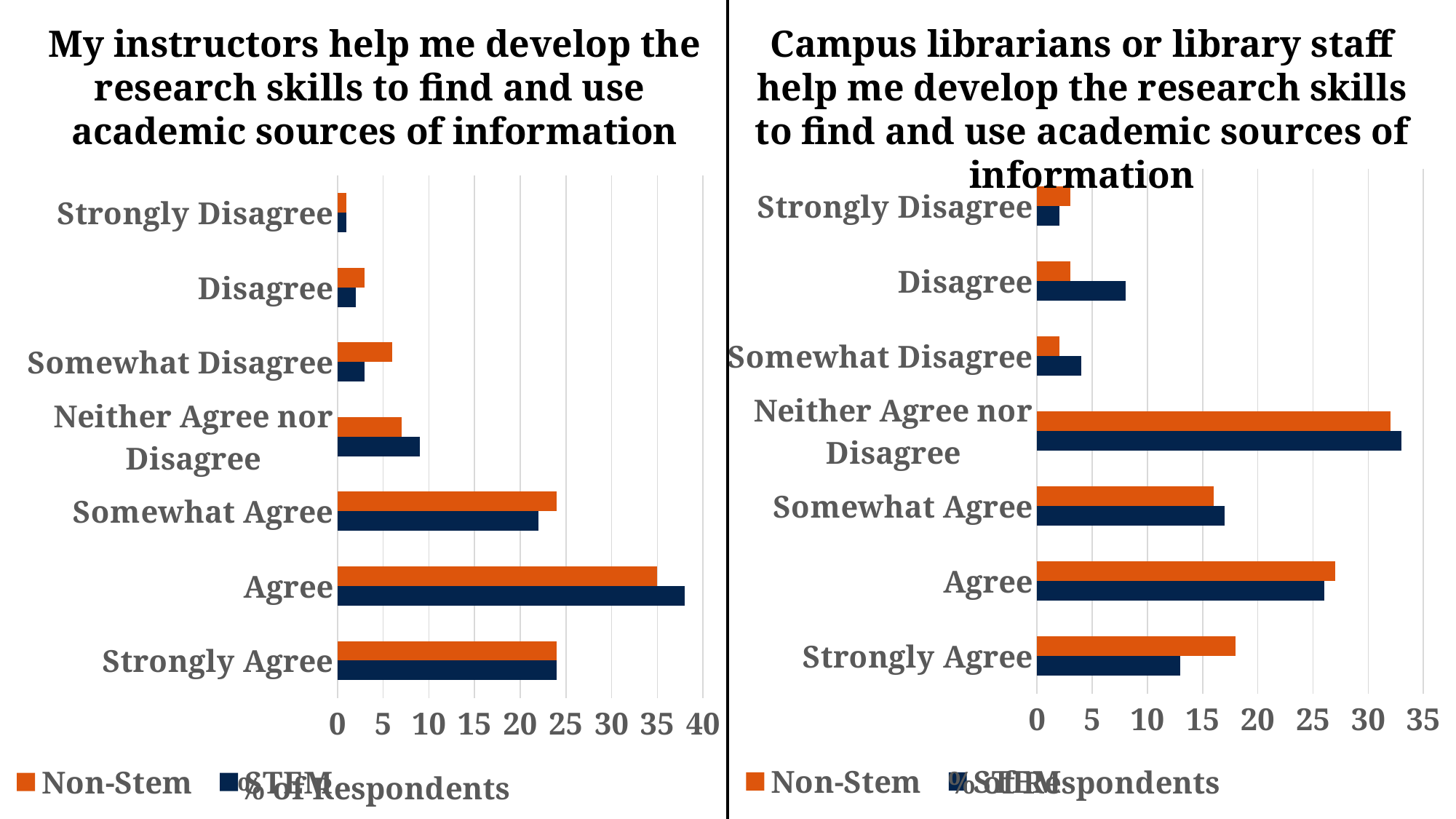
In the left chart ("My instructors help me develop..."), how many series does the legend list? 2 In the right chart ("Campus librarians or library staff help me develop..."), is the STEM value for Disagree greater or less than 5? greater In the left chart ("My instructors help me develop..."), which category has the highest STEM value? Agree What kind of chart is the left chart, titled "My instructors help me develop the research skills to find and use academic sources of information"? bar chart In the right chart ("Campus librarians or library staff help me develop..."), what is the highest tick value shown on the horizontal axis? 35 In the left chart ("My instructors help me develop..."), for the Agree category, which series has the larger value, Non-Stem or STEM? STEM In the right chart ("Campus librarians or library staff help me develop..."), which category has the highest Non-Stem value? Neither Agree nor Disagree In the right chart ("Campus librarians or library staff help me develop..."), which category has the lowest STEM value? Strongly Disagree In the left chart ("My instructors help me develop..."), how many response categories are shown on the vertical axis? 7 In the left chart ("My instructors help me develop..."), is the STEM value for Agree greater or less than 35? greater In the right chart ("Campus librarians or library staff help me develop..."), for the Strongly Agree category, which series has the larger value, Non-Stem or STEM? Non-Stem In the left chart ("My instructors help me develop..."), is the Non-Stem value for Somewhat Agree greater or less than 20? greater